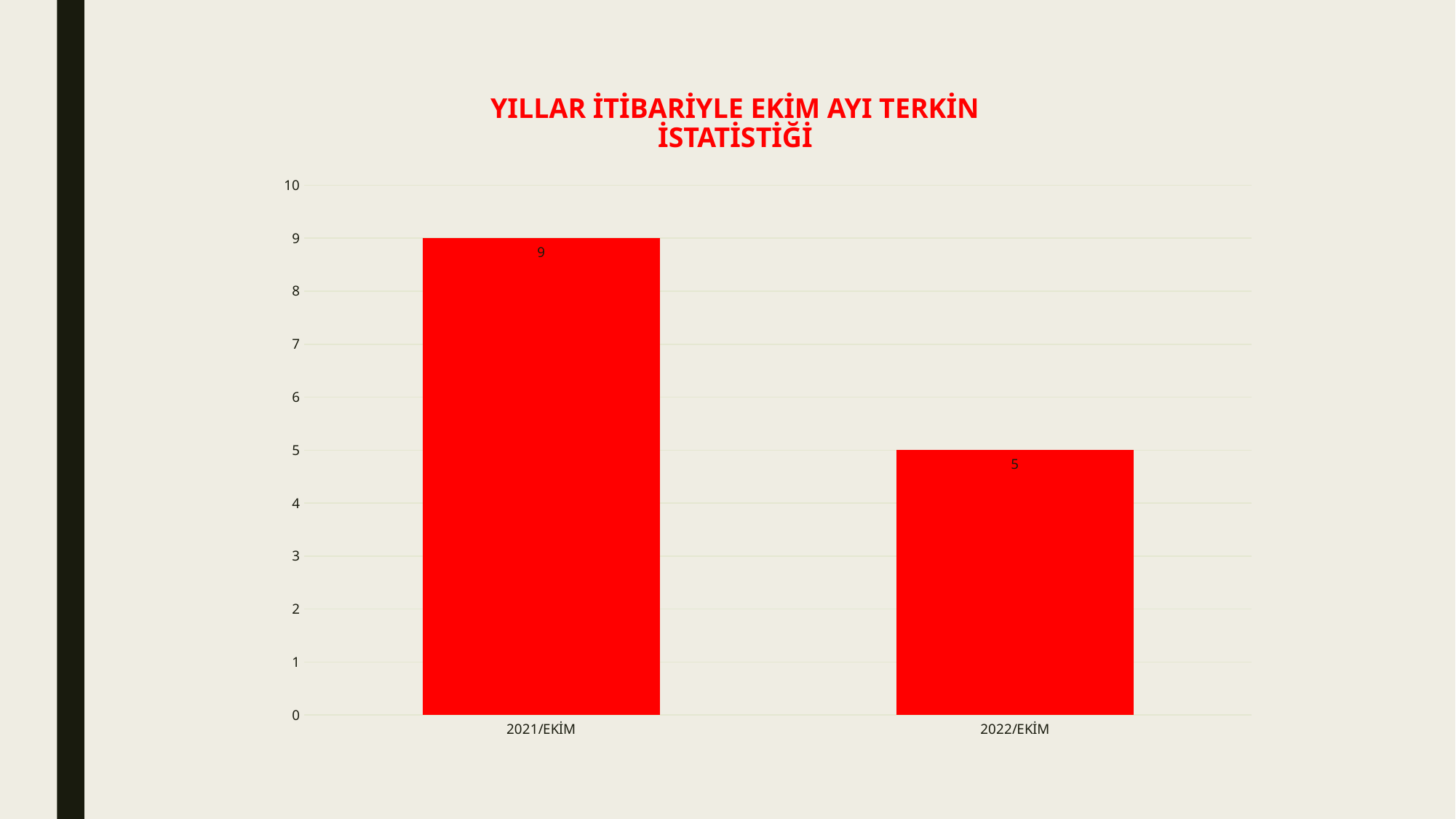
Is the value for 2022/EKİM greater or less than 7? less Which category has the highest value? 2021/EKİM Which category has the lowest value? 2022/EKİM What is the difference between the values for 2021/EKİM and 2022/EKİM? 4 Which is larger, the value for 2021/EKİM or the value for 2022/EKİM? 2021/EKİM What is the title of the chart? YILLAR İTİBARİYLE EKİM AYI TERKİN İSTATİSTİĞİ What is the value for 2021/EKİM? 9 Do the values rise or fall from 2021/EKİM to 2022/EKİM? fall How many categories are shown on the x axis? 2 What kind of chart is shown on the slide? bar chart Is the value for 2021/EKİM greater or less than 6? greater What is the value for 2022/EKİM? 5